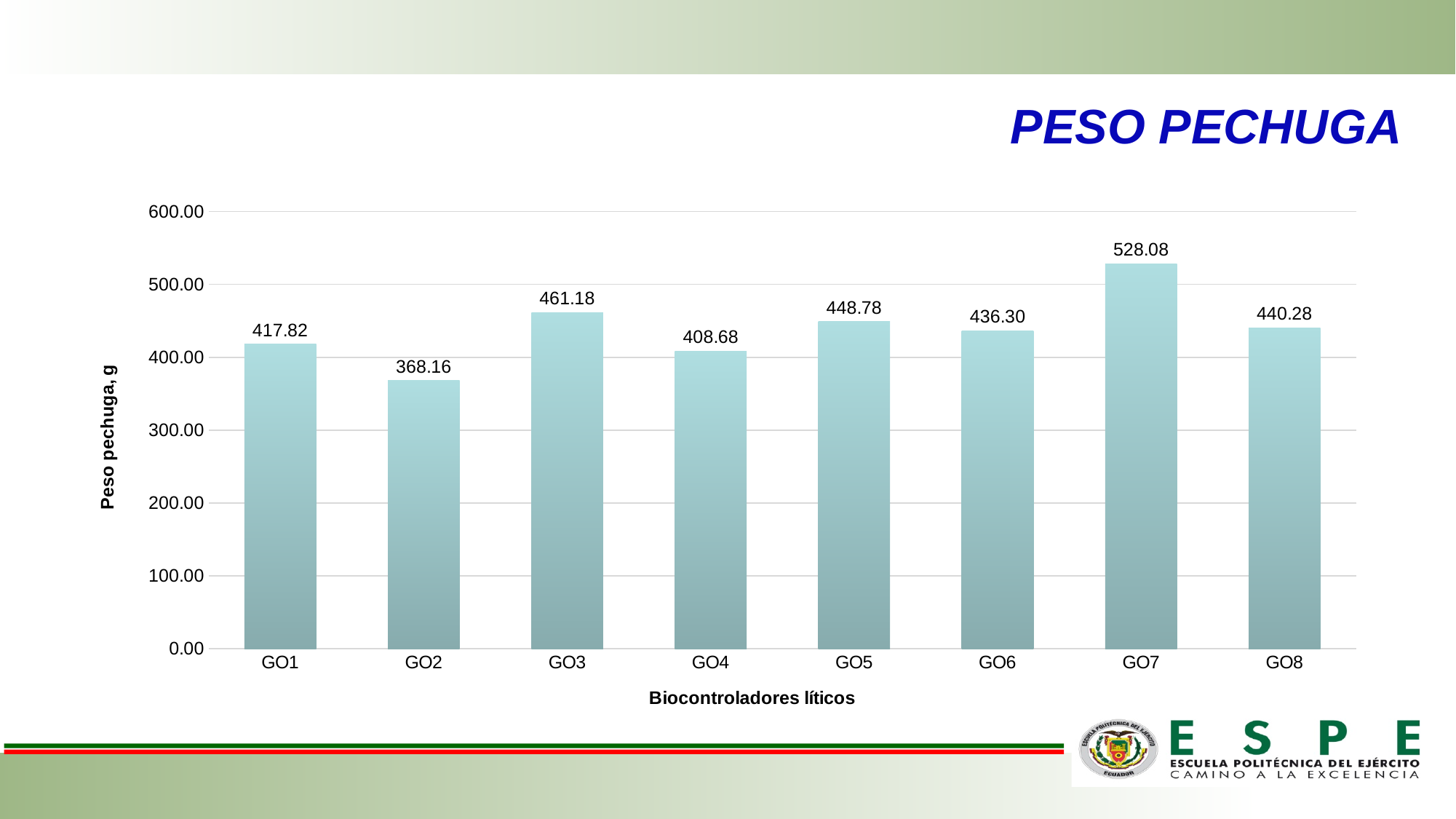
Which category has the highest value? GO7 What is the value for GO7? 528.08 What is the value for GO4? 408.68 What is the value for GO1? 417.82 What is the label of the x axis? Biocontroladores líticos Which is larger, the value for GO3 or the value for GO5? GO3 What is the title of the chart? PESO PECHUGA What is the difference between the values for GO7 and GO2? 159.92 How many categories are shown on the x axis? 8 Which category has the lowest value? GO2 Is the value for GO2 greater or less than 400.00? less What kind of chart is shown on the slide? bar chart